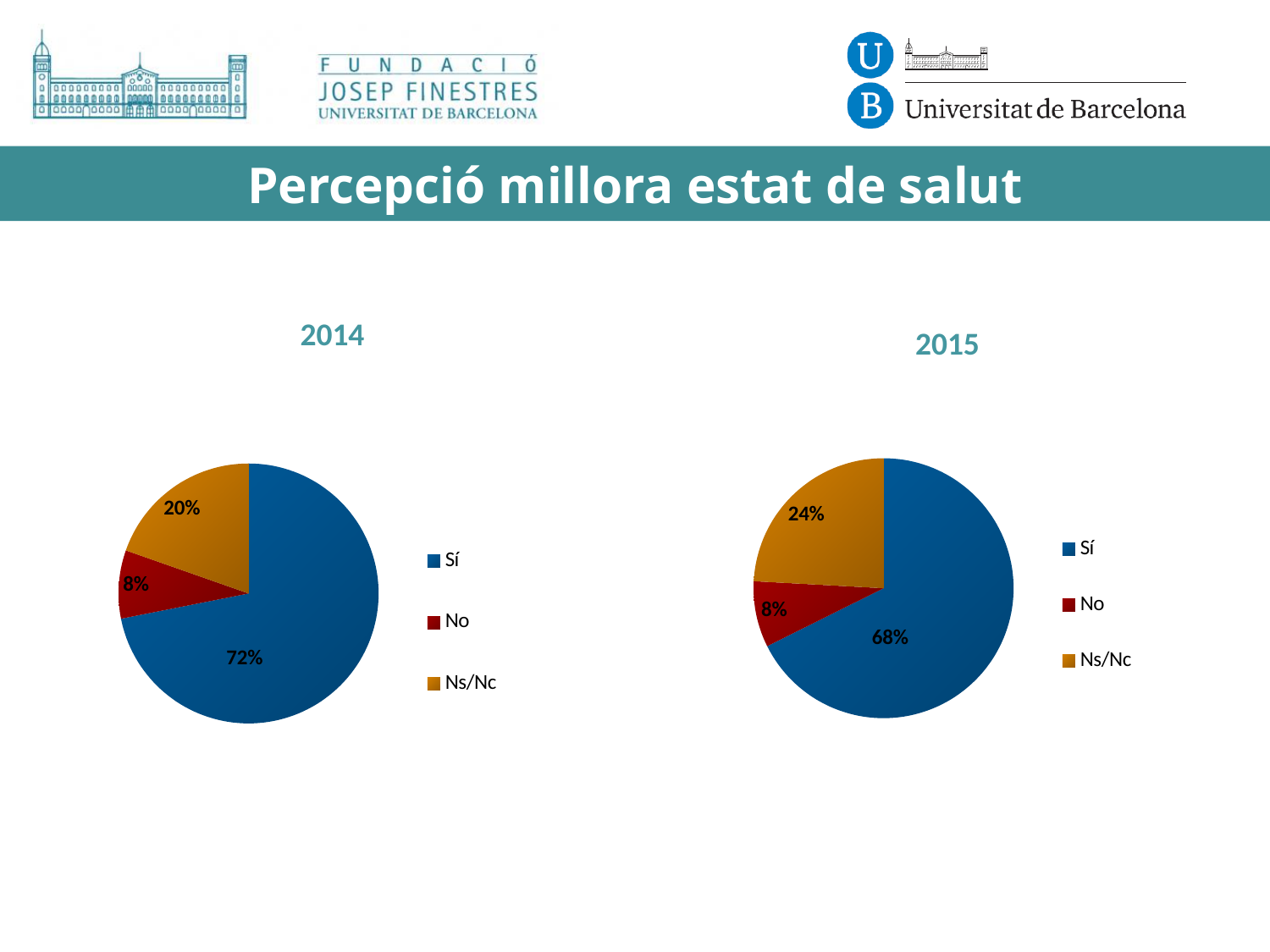
What colour represents Ns/Nc in the 2014 pie chart legend? Orange In the 2015 pie chart, what is the share for Sí? 68% How many categories does the 2014 pie chart show? 3 In the 2014 pie chart, which category has the smallest slice? No In the 2014 pie chart, what is the share for Sí? 72% Which is larger: the Ns/Nc share in 2014 or the Ns/Nc share in 2015? 2015 In the 2015 pie chart, which category has the largest slice? Sí In the 2014 pie chart, what is the share for No? 8% In the 2015 pie chart, what is the difference between the Ns/Nc share and the No share? 16% What kind of chart is used for the 2015 data? Pie chart In the 2015 pie chart, what is the share for Ns/Nc? 24% What is the difference between the Sí share in 2014 and the Sí share in 2015? 4%